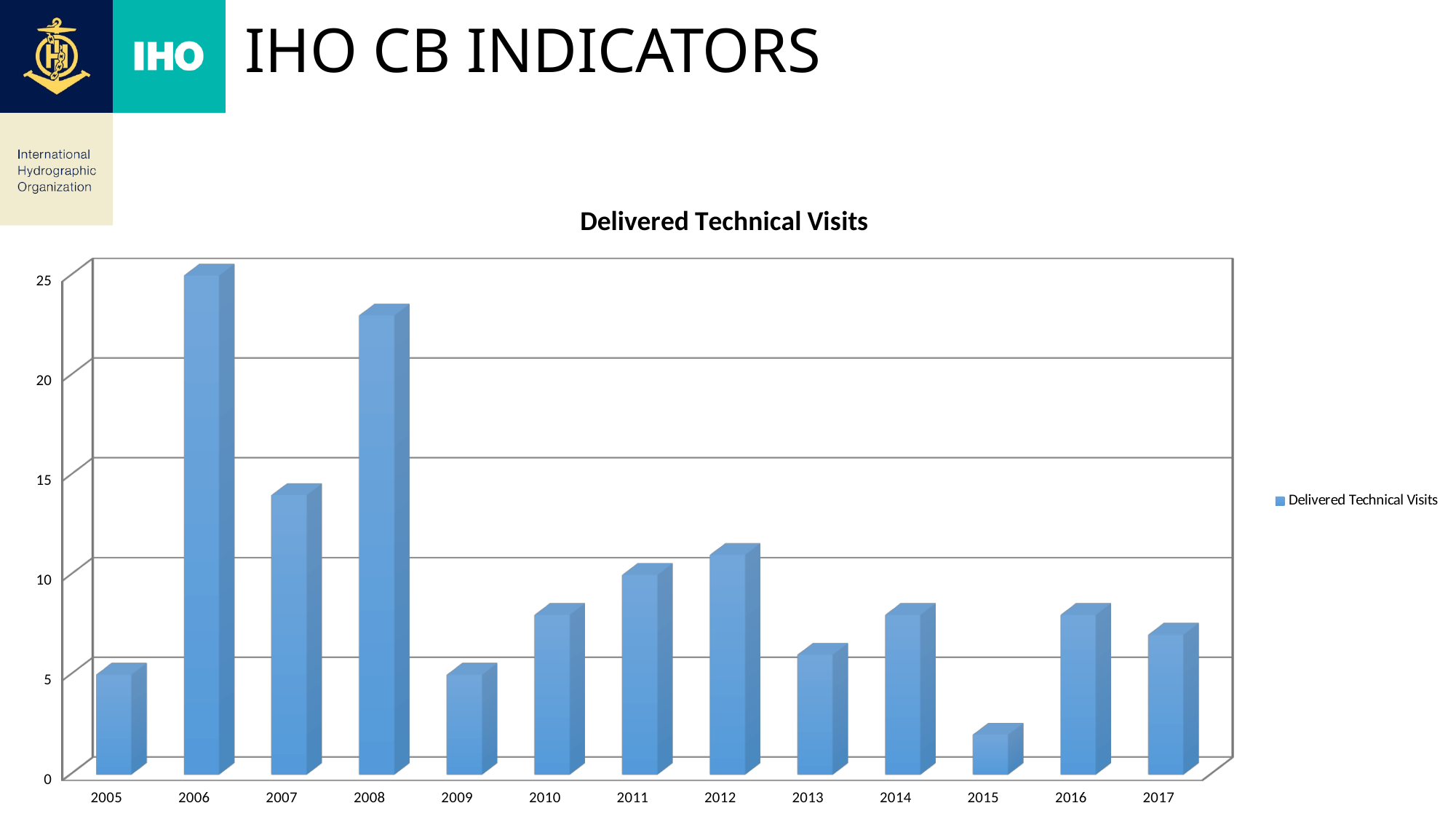
What is the title of the chart? Delivered Technical Visits How many series does the legend list? 1 How many years are shown on the x axis? 13 Is the value for 2008 greater or less than 20? greater Which year has more delivered technical visits, 2007 or 2008? 2008 Which year has the highest number of delivered technical visits? 2006 Is the value for 2007 greater or less than 10? greater Which year has more delivered technical visits, 2010 or 2012? 2012 Which year has the lowest number of delivered technical visits? 2015 What kind of chart is shown on the slide? bar chart Is the value for 2017 greater or less than 10? less